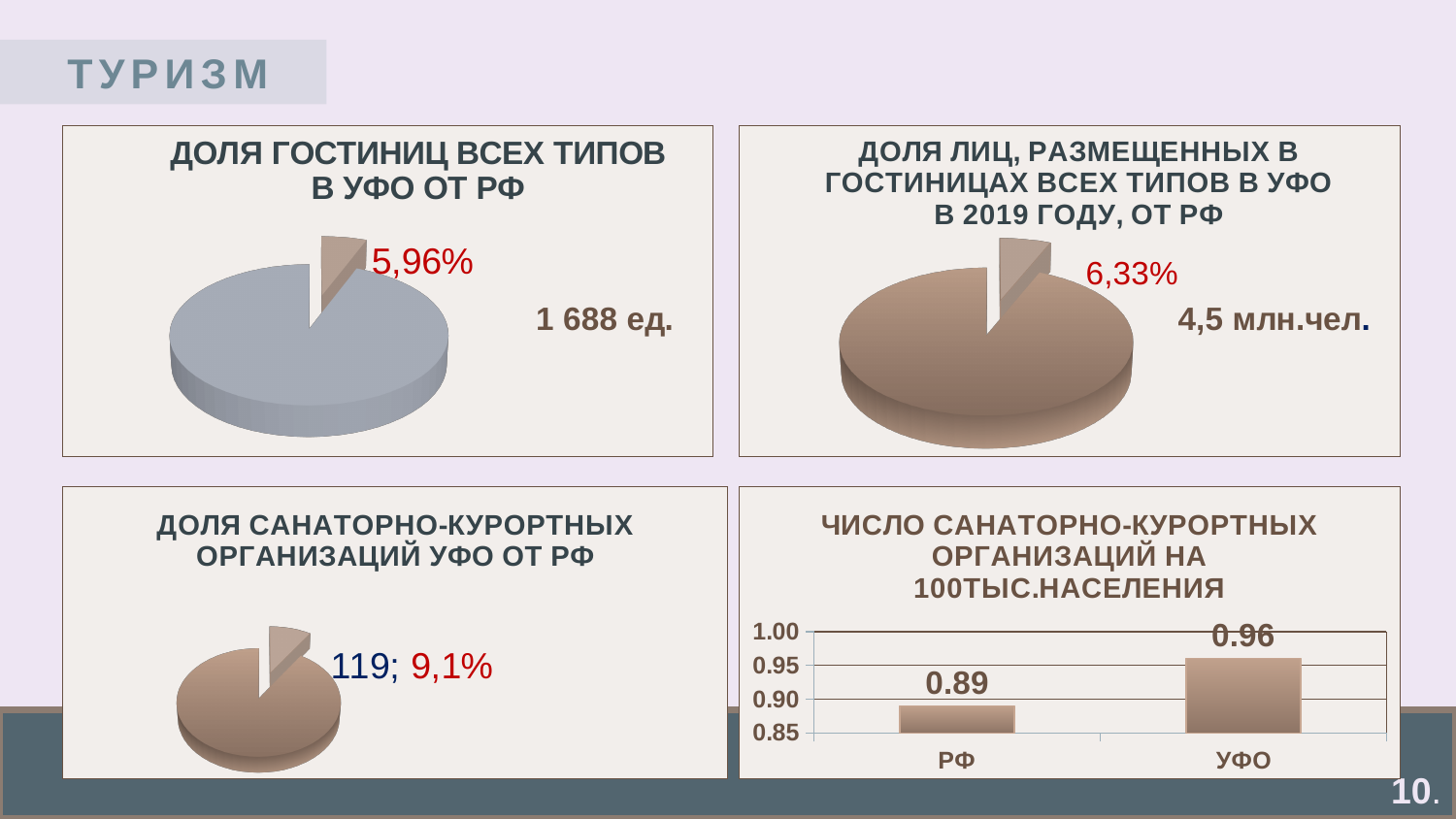
In the bottom-right chart 'ЧИСЛО САНАТОРНО-КУРОРТНЫХ ОРГАНИЗАЦИЙ НА 100ТЫС.НАСЕЛЕНИЯ', how many categories are shown on the x axis? 2 What kind of chart is the top-left chart 'ДОЛЯ ГОСТИНИЦ ВСЕХ ТИПОВ В УФО ОТ РФ'? pie chart In the bottom-right chart 'ЧИСЛО САНАТОРНО-КУРОРТНЫХ ОРГАНИЗАЦИЙ НА 100ТЫС.НАСЕЛЕНИЯ', is the value for РФ greater or less than 0.90? less In the bottom-right chart 'ЧИСЛО САНАТОРНО-КУРОРТНЫХ ОРГАНИЗАЦИЙ НА 100ТЫС.НАСЕЛЕНИЯ', what is the difference between the values for УФО and РФ? 0.07 In the top-left pie chart 'ДОЛЯ ГОСТИНИЦ ВСЕХ ТИПОВ В УФО ОТ РФ', what share does the highlighted slice represent? 5,96% In the bottom-right chart 'ЧИСЛО САНАТОРНО-КУРОРТНЫХ ОРГАНИЗАЦИЙ НА 100ТЫС.НАСЕЛЕНИЯ', which category has the higher value? УФО In the bottom-right chart 'ЧИСЛО САНАТОРНО-КУРОРТНЫХ ОРГАНИЗАЦИЙ НА 100ТЫС.НАСЕЛЕНИЯ', which category has the lower value? РФ In the top-right pie chart 'ДОЛЯ ЛИЦ, РАЗМЕЩЕННЫХ В ГОСТИНИЦАХ ВСЕХ ТИПОВ В УФО В 2019 ГОДУ, ОТ РФ', what share does the highlighted slice represent? 6,33% In the bottom-right chart 'ЧИСЛО САНАТОРНО-КУРОРТНЫХ ОРГАНИЗАЦИЙ НА 100ТЫС.НАСЕЛЕНИЯ', what is the value for РФ? 0.89 What kind of chart is the bottom-right chart 'ЧИСЛО САНАТОРНО-КУРОРТНЫХ ОРГАНИЗАЦИЙ НА 100ТЫС.НАСЕЛЕНИЯ'? bar chart In the bottom-right chart 'ЧИСЛО САНАТОРНО-КУРОРТНЫХ ОРГАНИЗАЦИЙ НА 100ТЫС.НАСЕЛЕНИЯ', what is the value for УФО? 0.96 In the bottom-left pie chart 'ДОЛЯ САНАТОРНО-КУРОРТНЫХ ОРГАНИЗАЦИЙ УФО ОТ РФ', what share does the highlighted slice represent? 9,1%